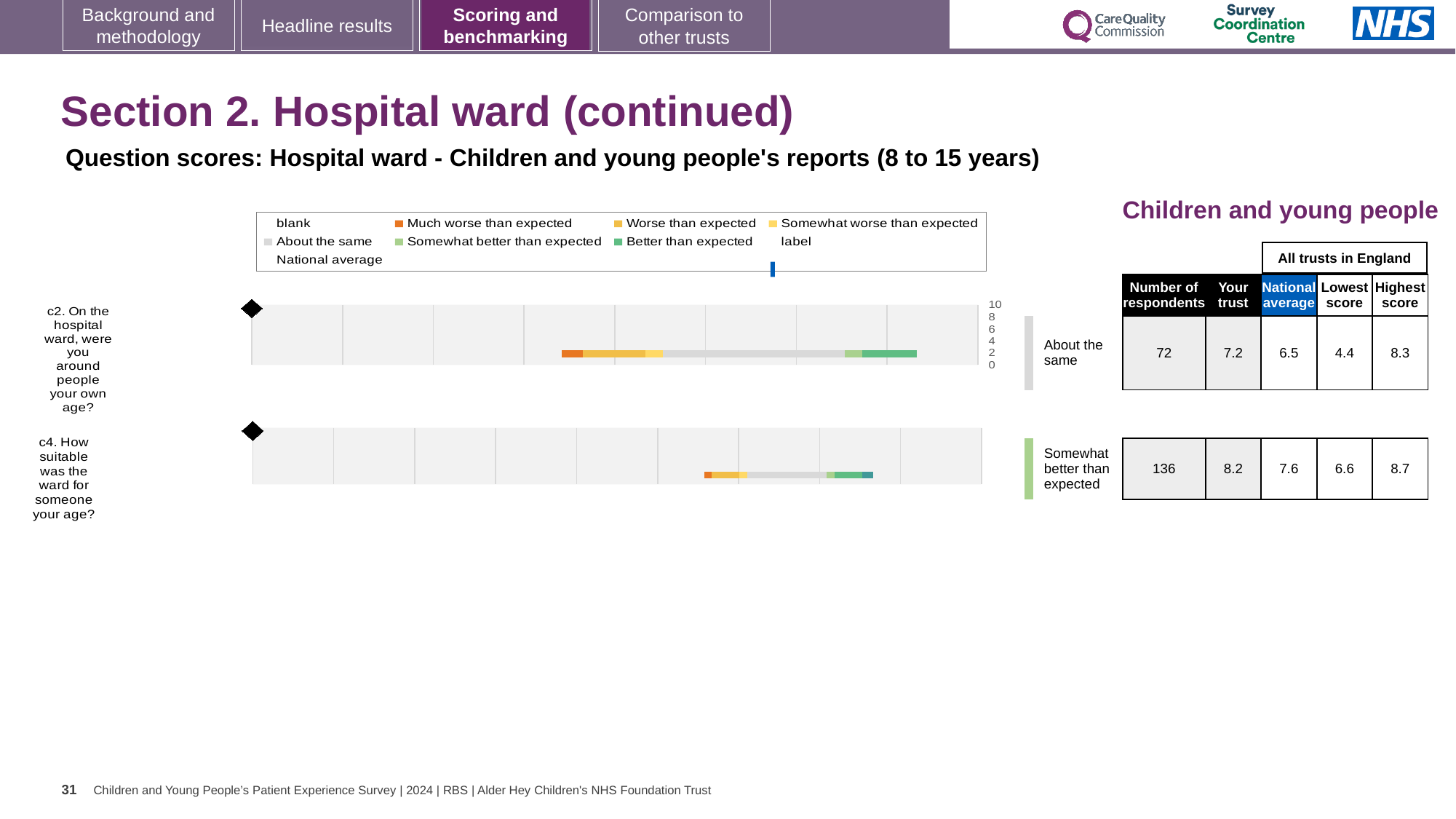
What kind of chart is used to show the question scores for c2 and c4? bar chart What is the difference between the 'Your trust' score and the national average for c2? 0.7 What does the blue marker in the chart legend represent? National average What is the highest score among all trusts in England for c4? 8.7 What is the 'Your trust' score for c2 (On the hospital ward, were you around people your own age?)? 7.2 How many questions are plotted in the chart? 2 Which question has the higher 'Your trust' score, c2 or c4? c4 What is the lowest score among all trusts in England for c2? 4.4 What is the national average score for c4 (How suitable was the ward for someone your age?)? 7.6 Which colour in the legend represents 'Much worse than expected'? orange How many respondents answered c2? 72 Which benchmark category is c4 rated as? Somewhat better than expected